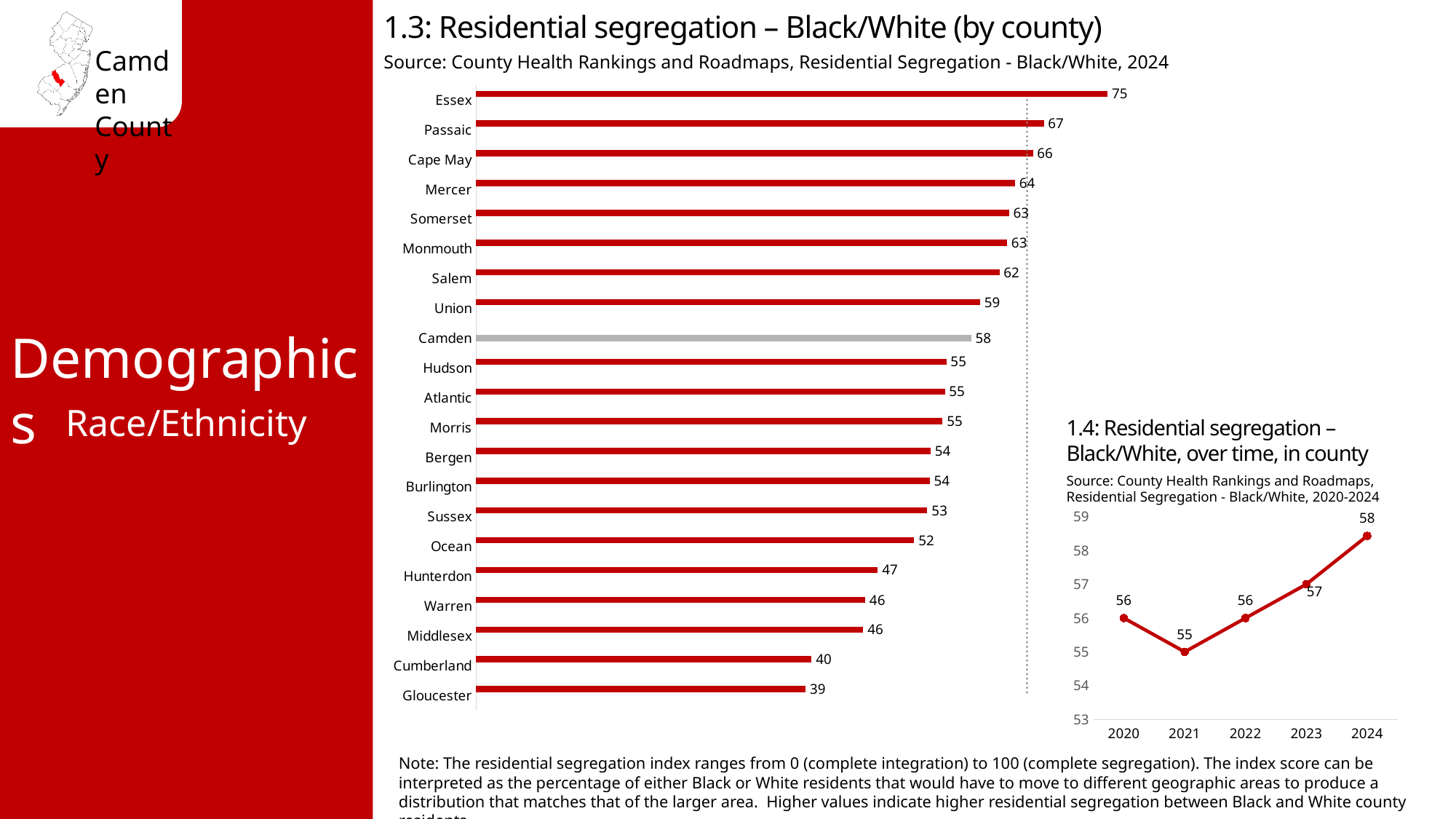
In the chart '1.3: Residential segregation – Black/White (by county)', which county has the lowest value? Gloucester In the chart '1.4: Residential segregation – Black/White, over time, in county', what is the difference between the values for 2024 and 2020? 2 How many counties are shown in the chart '1.3: Residential segregation – Black/White (by county)'? 21 In the chart '1.3: Residential segregation – Black/White (by county)', what is the difference between the values for Essex and Gloucester? 36 In the chart '1.3: Residential segregation – Black/White (by county)', which has a larger value, Passaic or Union? Passaic In the chart '1.3: Residential segregation – Black/White (by county)', what is the value for Cumberland? 40 In the chart '1.3: Residential segregation – Black/White (by county)', which county has the highest value? Essex In the chart '1.3: Residential segregation – Black/White (by county)', what is the value for Camden? 58 In the chart '1.4: Residential segregation – Black/White, over time, in county', which year has the highest value? 2024 In the chart '1.4: Residential segregation – Black/White, over time, in county', what is the value for 2021? 55 What kind of chart is '1.4: Residential segregation – Black/White, over time, in county'? Line chart What kind of chart is '1.3: Residential segregation – Black/White (by county)'? Bar chart